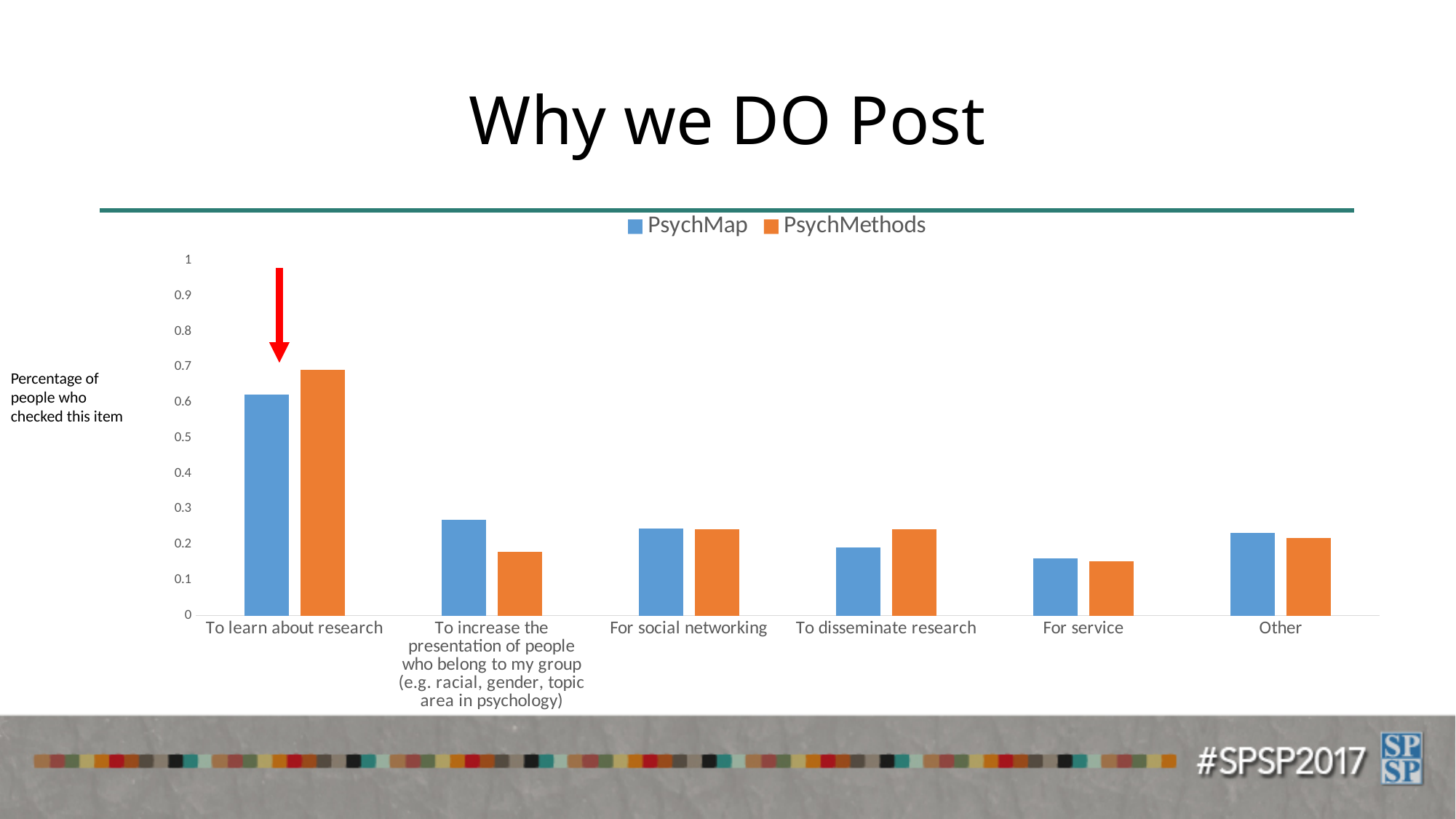
Which category has the lowest PsychMethods value? For service Which category has the highest PsychMap value? To learn about research Is the PsychMap value for 'To increase the presentation of people who belong to my group' greater or less than 0.3? less For 'To disseminate research', which series has the larger value, PsychMap or PsychMethods? PsychMethods Which category has the highest PsychMethods value? To learn about research How many series does the legend list? 2 Is the PsychMap value for 'To learn about research' greater or less than 0.5? greater What kind of chart is shown on the slide? bar chart Is the PsychMethods value for 'To learn about research' greater or less than 0.6? greater What does the y axis of the chart represent, according to the label on the slide? Percentage of people who checked this item How many categories are shown on the x axis? 6 For 'To learn about research', which series has the larger value, PsychMap or PsychMethods? PsychMethods